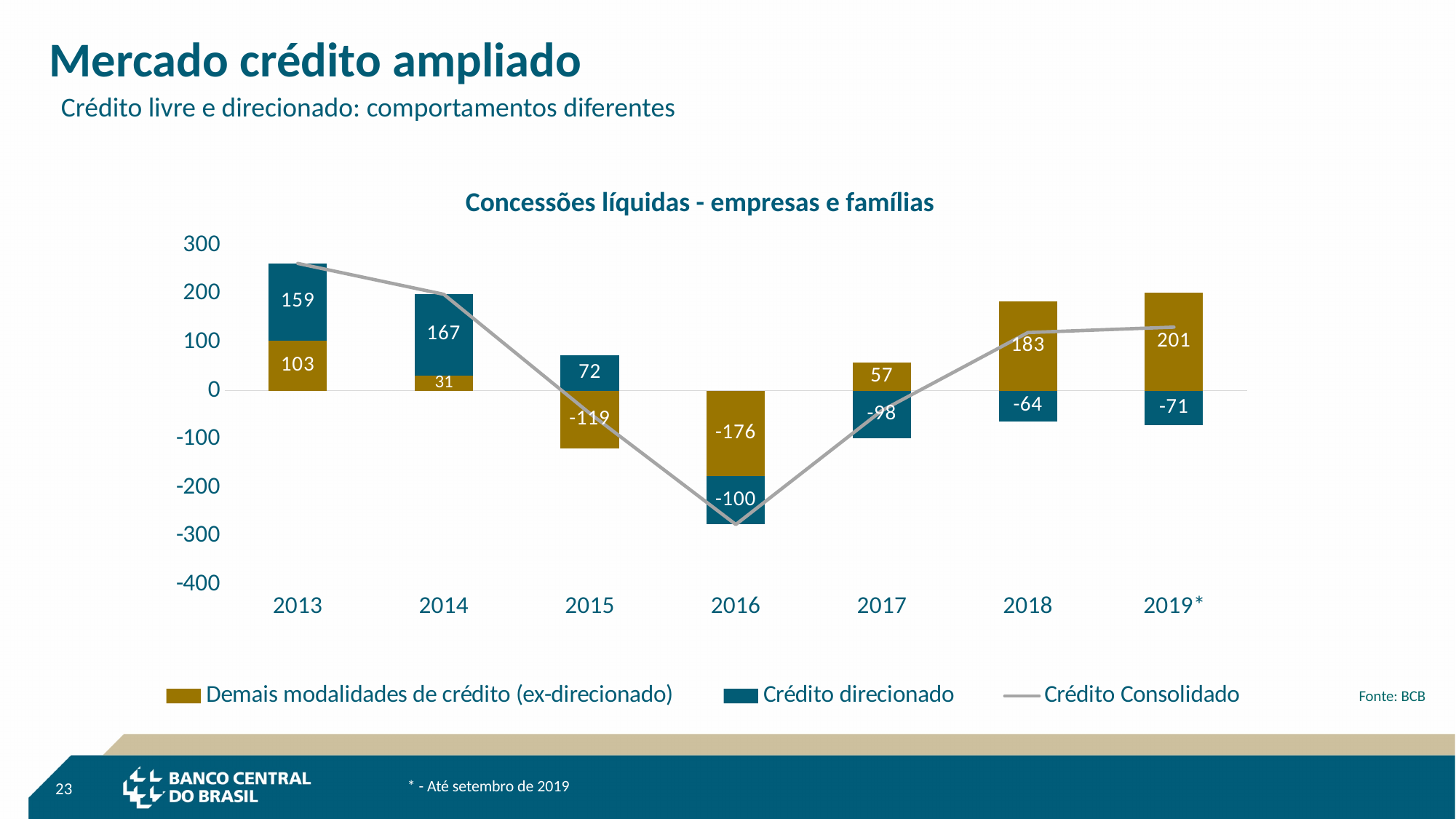
How many years are shown on the x axis? 7 How many series does the legend list? 3 What is the value of Crédito direcionado in 2019*? -71 What is the total of the stacked bar for 2013 (Demais modalidades plus Crédito direcionado)? 262 What is the value of Demais modalidades de crédito (ex-direcionado) in 2016? -176 In which year is Demais modalidades de crédito (ex-direcionado) highest? 2019* What is the title of the chart? Concessões líquidas - empresas e famílias Which is larger in 2013: Crédito direcionado or Demais modalidades de crédito (ex-direcionado)? Crédito direcionado In which year is Crédito direcionado lowest? 2016 Is the Crédito Consolidado value for 2016 greater or less than -200? less What is the difference between Demais modalidades de crédito (ex-direcionado) in 2019* and in 2018? 18 What is the value of Crédito direcionado in 2014? 167